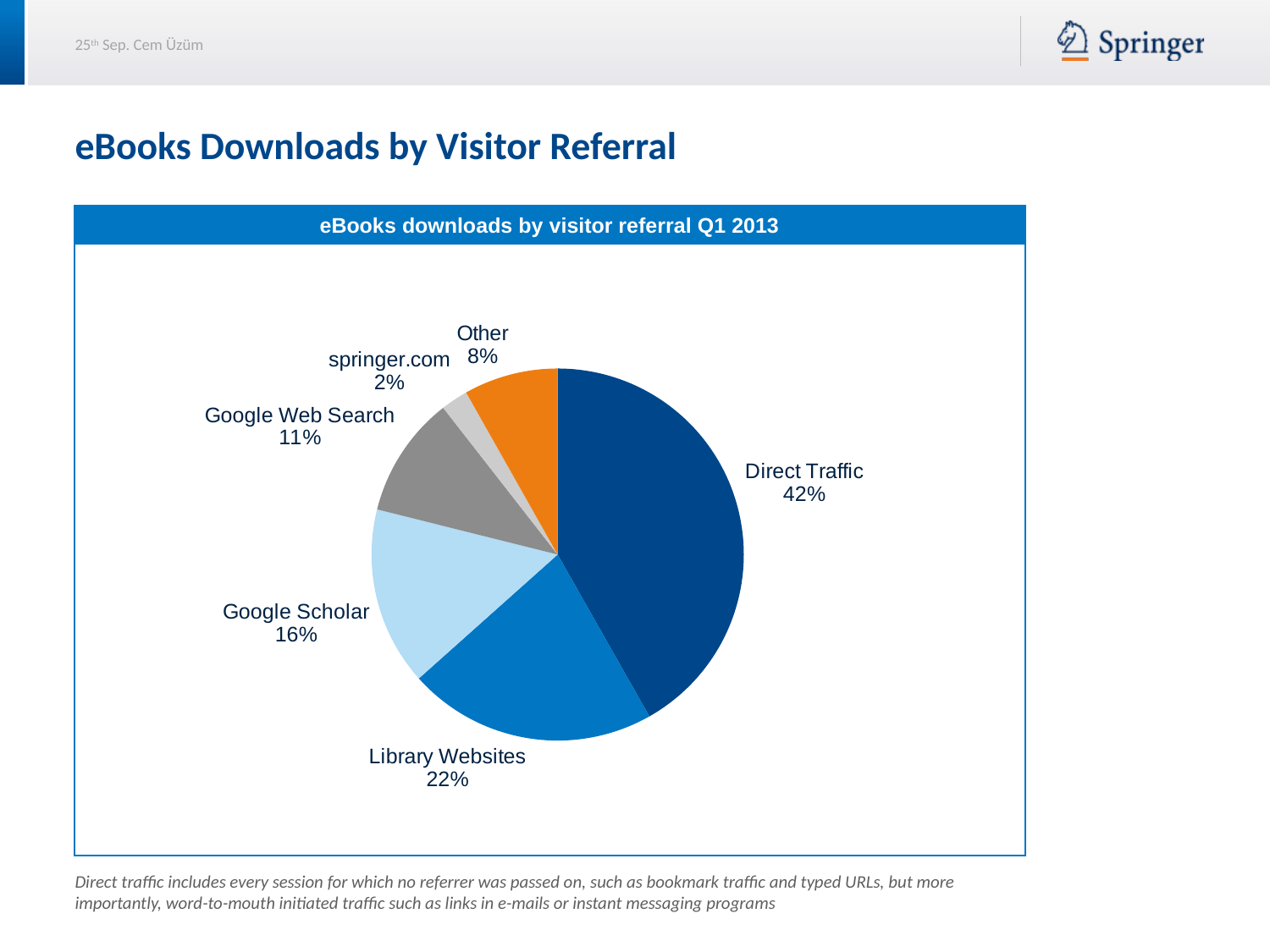
What share of eBooks downloads came from Google Web Search? 11% What is the title of the chart? eBooks downloads by visitor referral Q1 2013 What share of eBooks downloads came from springer.com? 2% Which referral source has the smallest share of eBooks downloads? springer.com What kind of chart is shown on the slide? Pie chart What is the difference in share between Direct Traffic and Library Websites? 20% What share of eBooks downloads came from Direct Traffic? 42% How many referral categories are shown in the pie chart? 6 Which referral source has the largest share of eBooks downloads? Direct Traffic Which has a larger share, Google Scholar or Google Web Search? Google Scholar